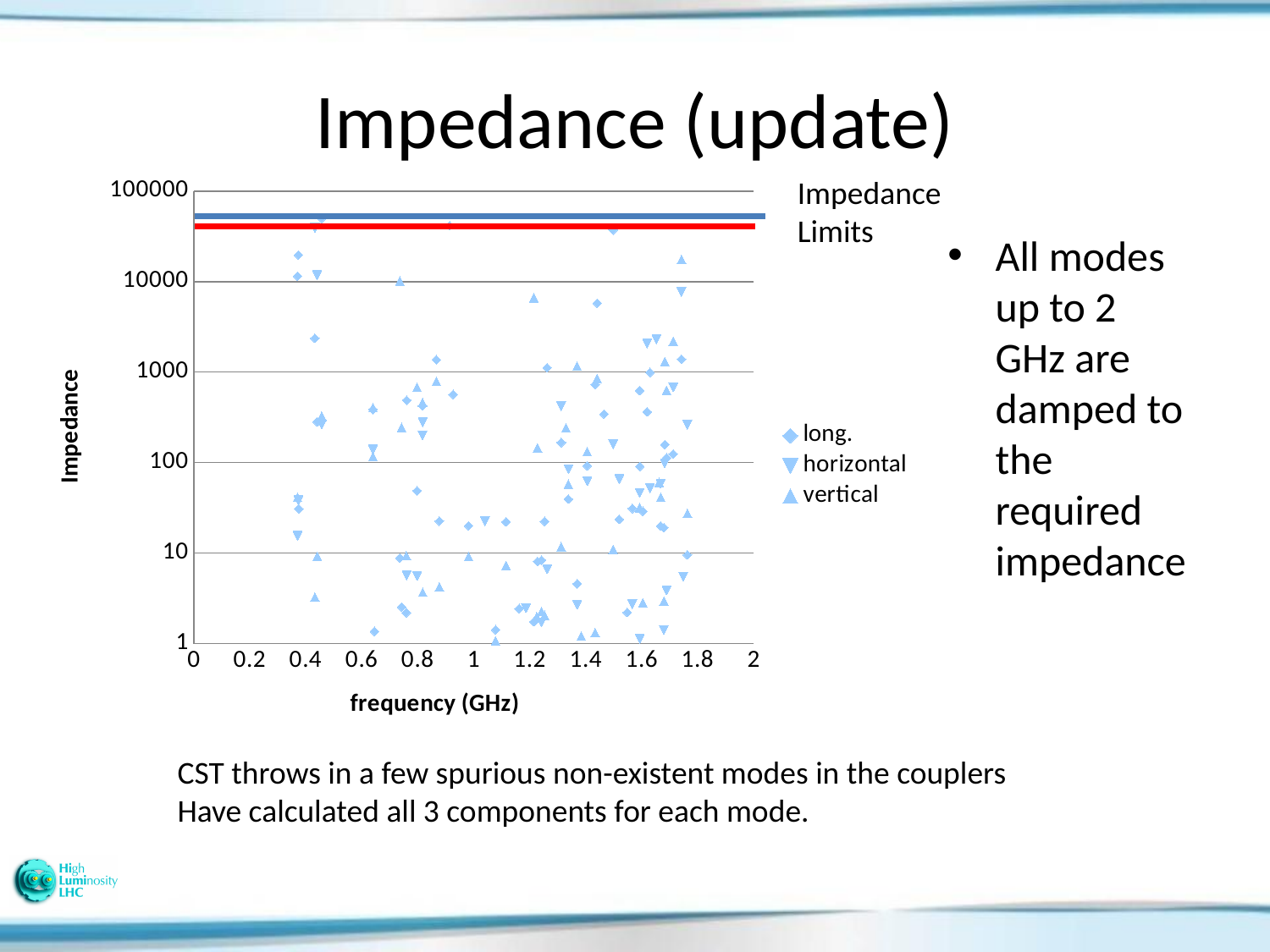
How many series does the legend list? 3 Is the highest plotted impedance point greater or less than 10000? greater Is the lowest plotted impedance point greater or less than 10? less What is the highest frequency value shown on the x axis? 2 What is the highest value shown on the y axis? 100000 What is the title of the x axis? frequency (GHz) Are the horizontal 'Impedance Limits' lines drawn above or below 10000 on the y axis? above What are the three series named in the legend? long., horizontal, vertical What kind of chart is shown on the slide? scatter chart